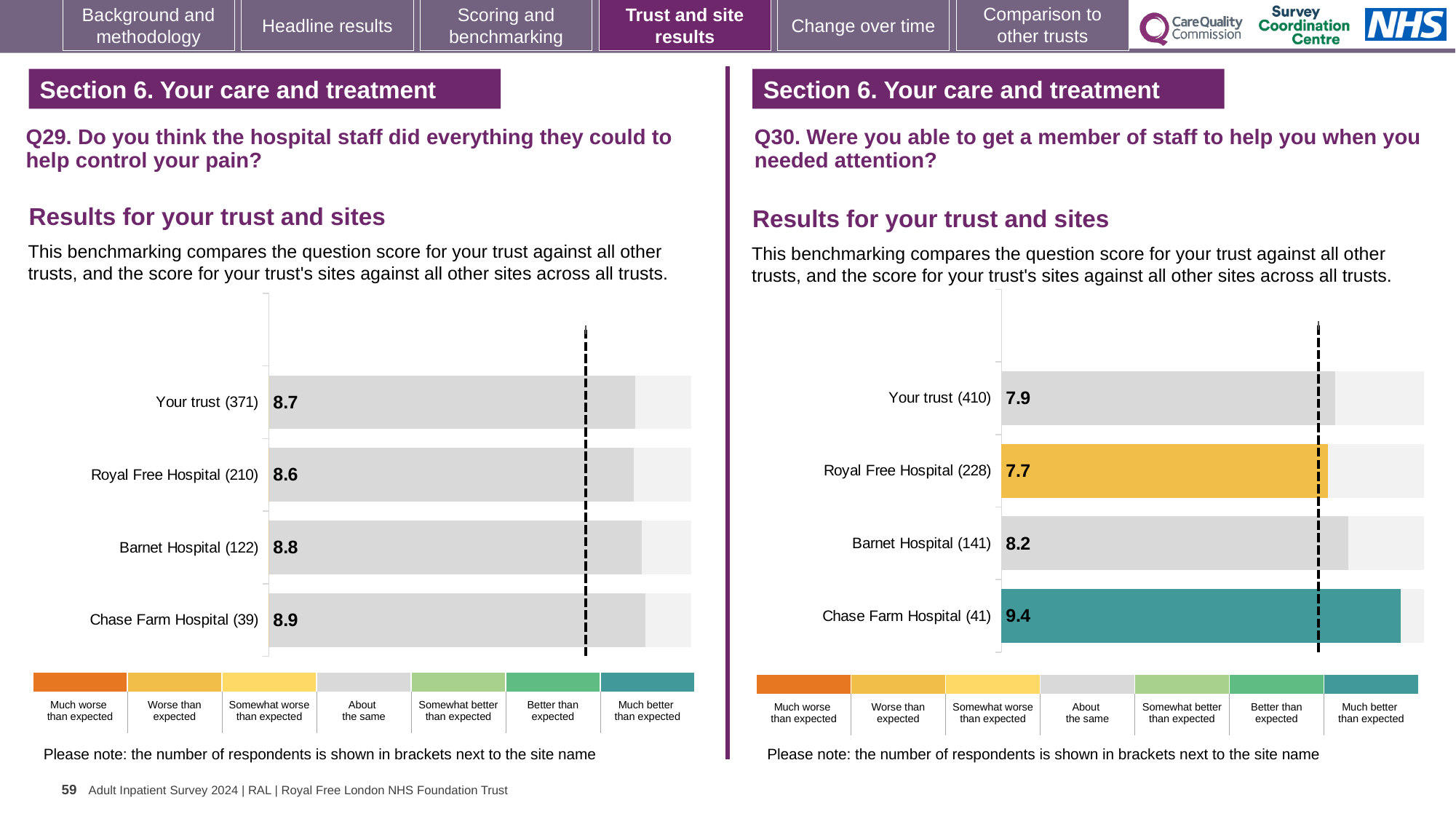
In the Q29 chart on the left, how many respondents are shown in brackets for Barnet Hospital? 122 In the Q30 chart on the right, which has the larger score, Barnet Hospital or Royal Free Hospital? Barnet Hospital What type of chart is used on this slide? Bar chart In the Q29 chart on the left, what is the score for Your trust? 8.7 In the Q29 chart on the left, what is the score for Chase Farm Hospital? 8.9 In the Q30 chart on the right, what is the difference between the scores for Chase Farm Hospital and Your trust? 1.5 In the Q30 chart on the right, which benchmark category does the colour of the Chase Farm Hospital bar correspond to? Much better than expected In the Q30 chart on the right, what is the score for Royal Free Hospital? 7.7 In the Q29 chart on the left, how many bars are plotted? 4 In the Q30 chart on the right, what is the score for Barnet Hospital? 8.2 In the Q30 chart on the right, which site has the highest score? Chase Farm Hospital In the Q29 chart on the left, which site has the lowest score? Royal Free Hospital